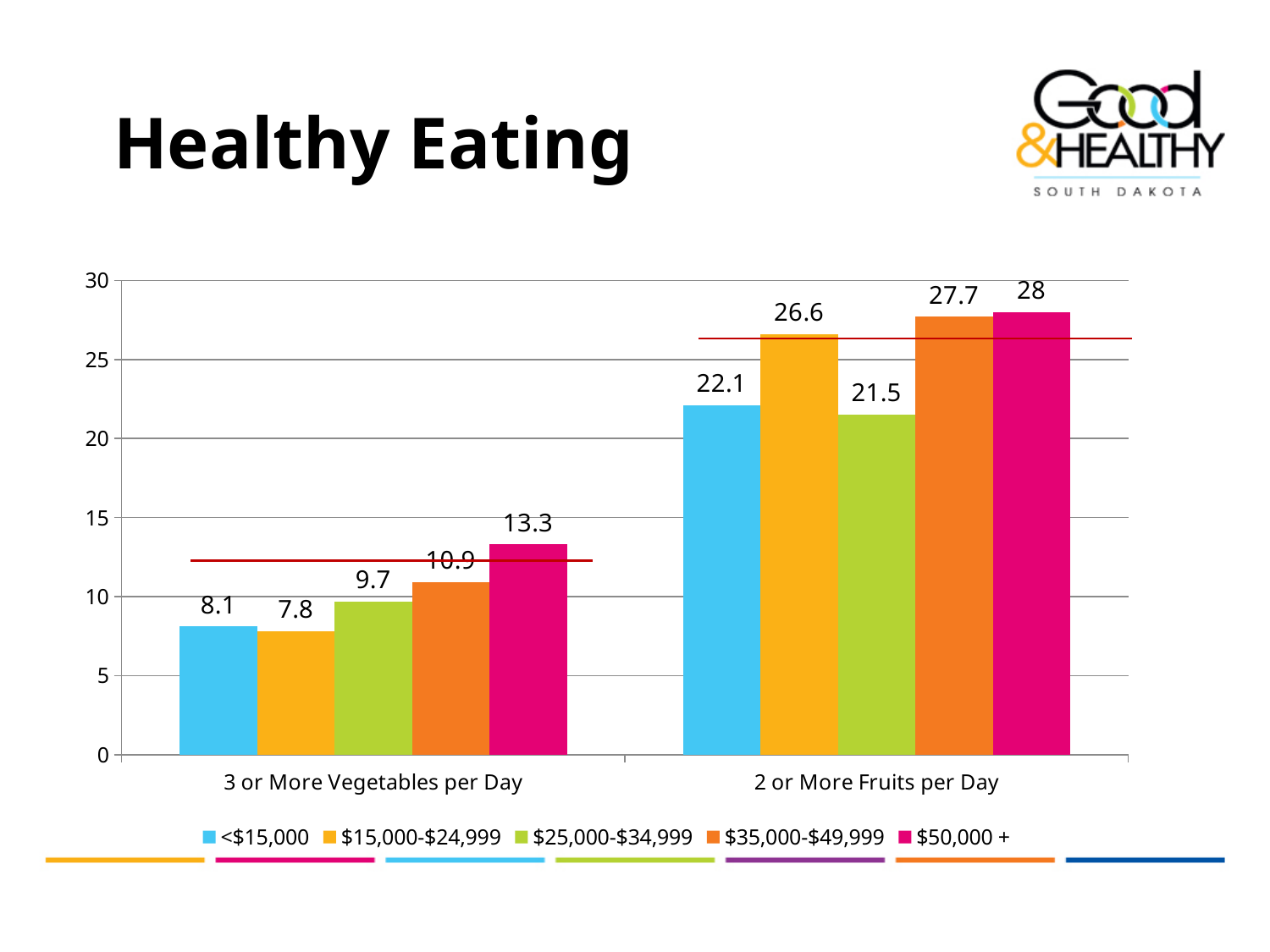
What is the value for the $25,000-$34,999 income group for 2 or More Fruits per Day? 21.5 What is the difference between the $50,000 + and <$15,000 values for 3 or More Vegetables per Day? 5.2 What is the value for the $50,000 + income group for 3 or More Vegetables per Day? 13.3 Which is larger for 2 or More Fruits per Day: the value for $15,000-$24,999 or the value for $25,000-$34,999? $15,000-$24,999 How many series does the legend list? 5 Is the value for $35,000-$49,999 for 2 or More Fruits per Day greater or less than 25? greater Which income group has the highest value for 2 or More Fruits per Day? $50,000 + How many categories are shown on the x axis? 2 What is the value for the <$15,000 income group for 2 or More Fruits per Day? 22.1 What kind of chart is shown on the slide? Bar chart What is the difference between the $15,000-$24,999 and $25,000-$34,999 values for 2 or More Fruits per Day? 5.1 Which income group has the lowest value for 3 or More Vegetables per Day? $15,000-$24,999